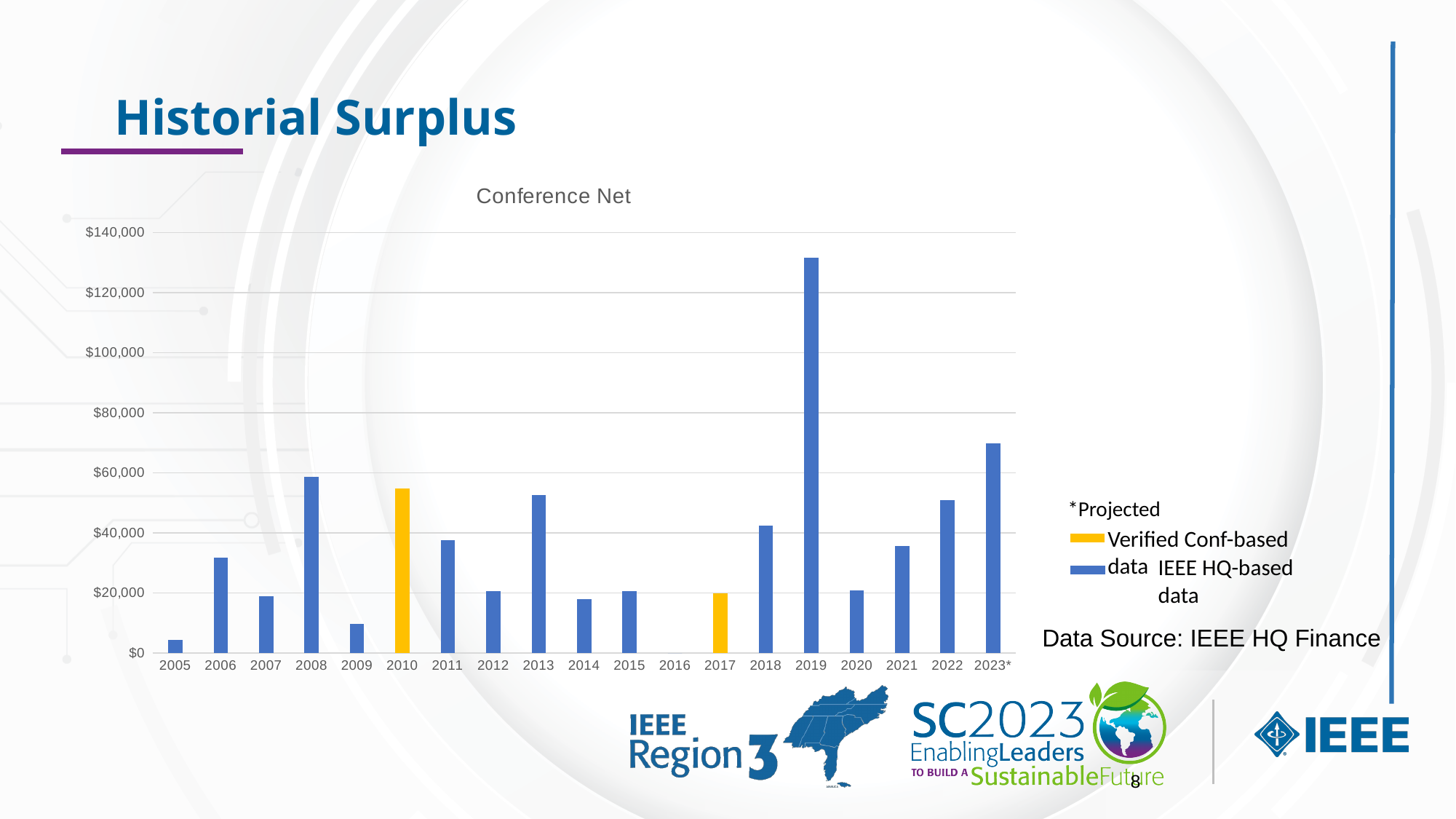
What type of chart is shown on the slide? bar chart Is the value for 2009 greater or less than $20,000? less Which year has the larger value, 2008 or 2009? 2008 How many entries does the chart legend list? 2 How many years are shown on the x axis of the chart? 19 Is the value for 2019 greater or less than $120,000? greater Is the value for 2005 greater or less than $20,000? less What is the title of the chart? Conference Net Which year has the highest Conference Net value? 2019 Which year has the larger value, 2019 or 2023*? 2019 What colour are the bars for 2010 and 2017, which represent Verified Conf-based data? yellow